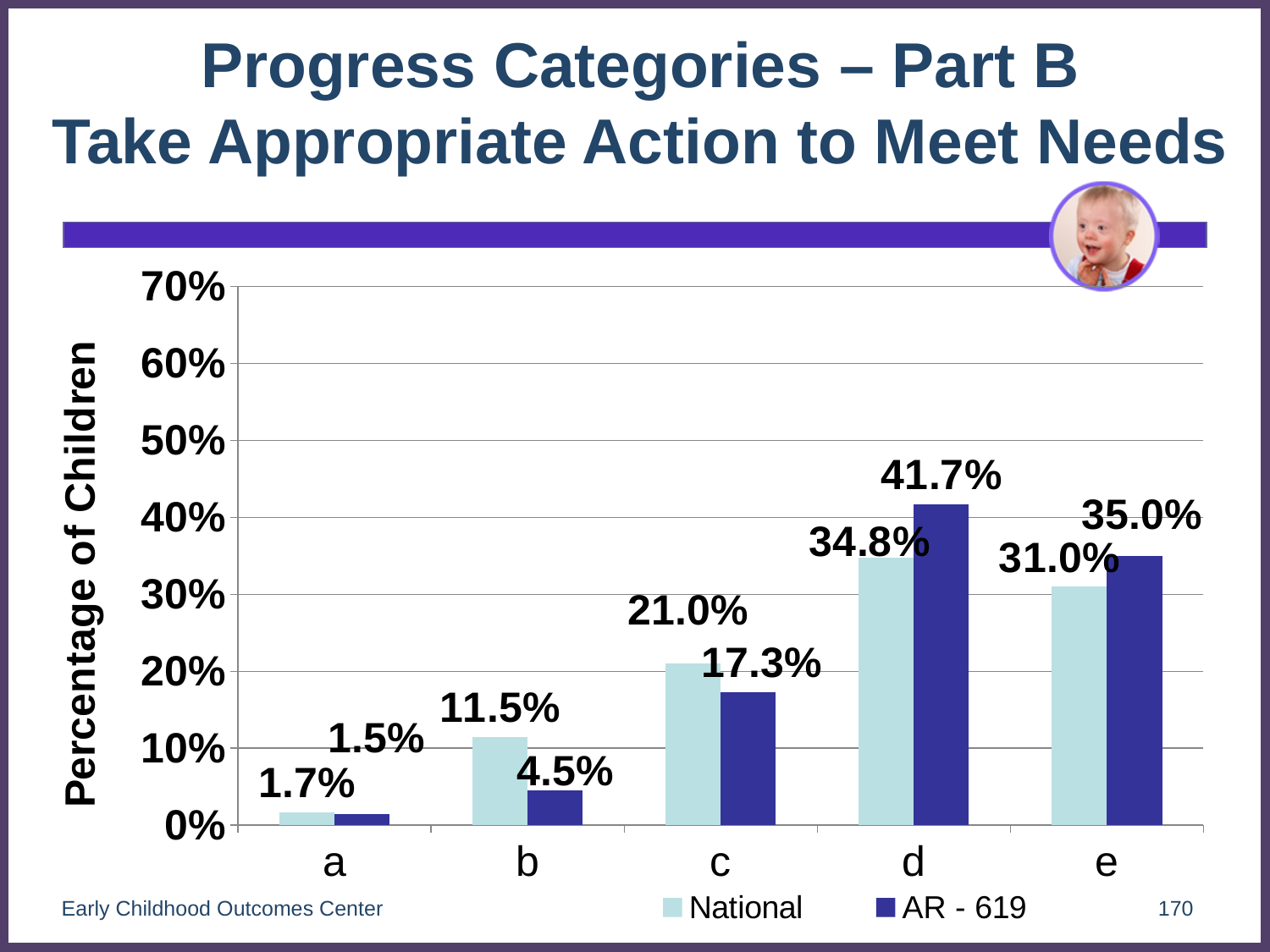
What is the AR - 619 value for category b? 4.5% Is the AR - 619 value for category e greater or less than 30%? greater How many categories are shown on the x axis? 5 Which category has the lowest National value? a How many series does the legend list? 2 What is the difference between the AR - 619 and National values for category d? 6.9% Which category has the highest AR - 619 value? d What kind of chart is shown on the slide? bar chart What is the National value for category a? 1.7% What is the label of the y axis? Percentage of Children What is the National value for category d? 34.8% For category c, which series has the larger value, National or AR - 619? National